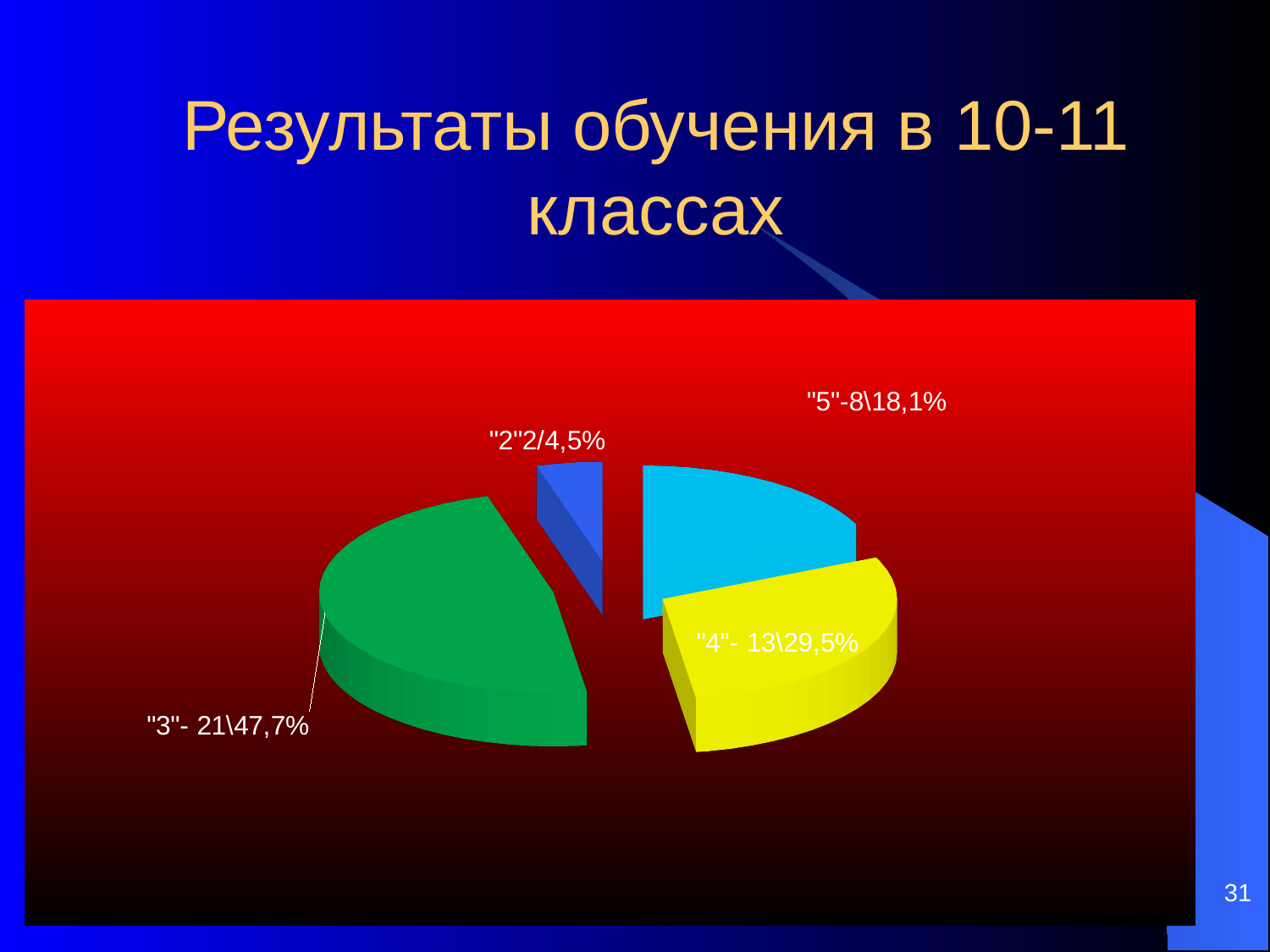
What colour is the slice for grade "4"? yellow What is the difference between the number of students with grade "3" and grade "4"? 8 What percentage is shown for the "5" slice? 18,1% What kind of chart is shown on the slide? pie chart Which is larger, the share for grade "5" or grade "4"? "4" How many slices does the pie chart have? 4 How many students are shown for the "2" grade? 2 Which grade has the largest slice of the pie? "3" How many students are shown for the "4" grade? 13 Which grade has the smallest slice of the pie? "2" What percentage is shown for the "3" slice? 47,7% What is the title of the slide containing the chart? Результаты обучения в 10-11 классах